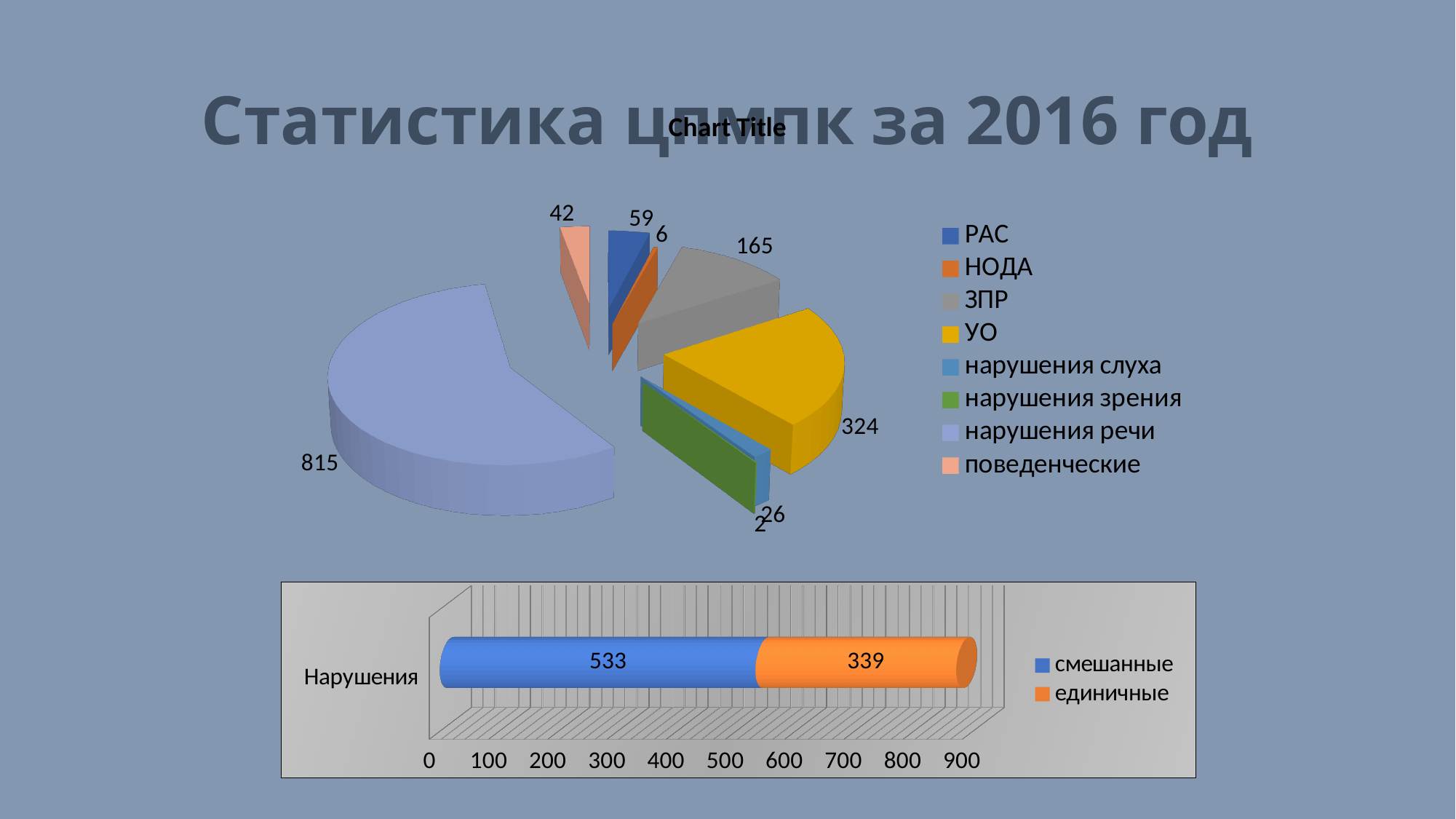
In the bottom bar chart, what is the total of the stacked bar for Нарушения? 872 In the pie chart, what is the value for ЗПР? 165 What kind of chart is the bottom chart on the slide? Stacked bar chart In the pie chart, what is the difference between the values for УО and ЗПР? 159 In the bottom bar chart, what is the value for смешанные? 533 In the pie chart, which category has the largest slice? нарушения речи In the pie chart, what is the value for нарушения речи? 815 In the pie chart, which is larger, УО or ЗПР? УО In the bottom bar chart, what is the value for единичные? 339 How many categories does the legend of the pie chart list? 8 In the pie chart, what is the value for УО? 324 In the pie chart, what is the value for РАС? 59